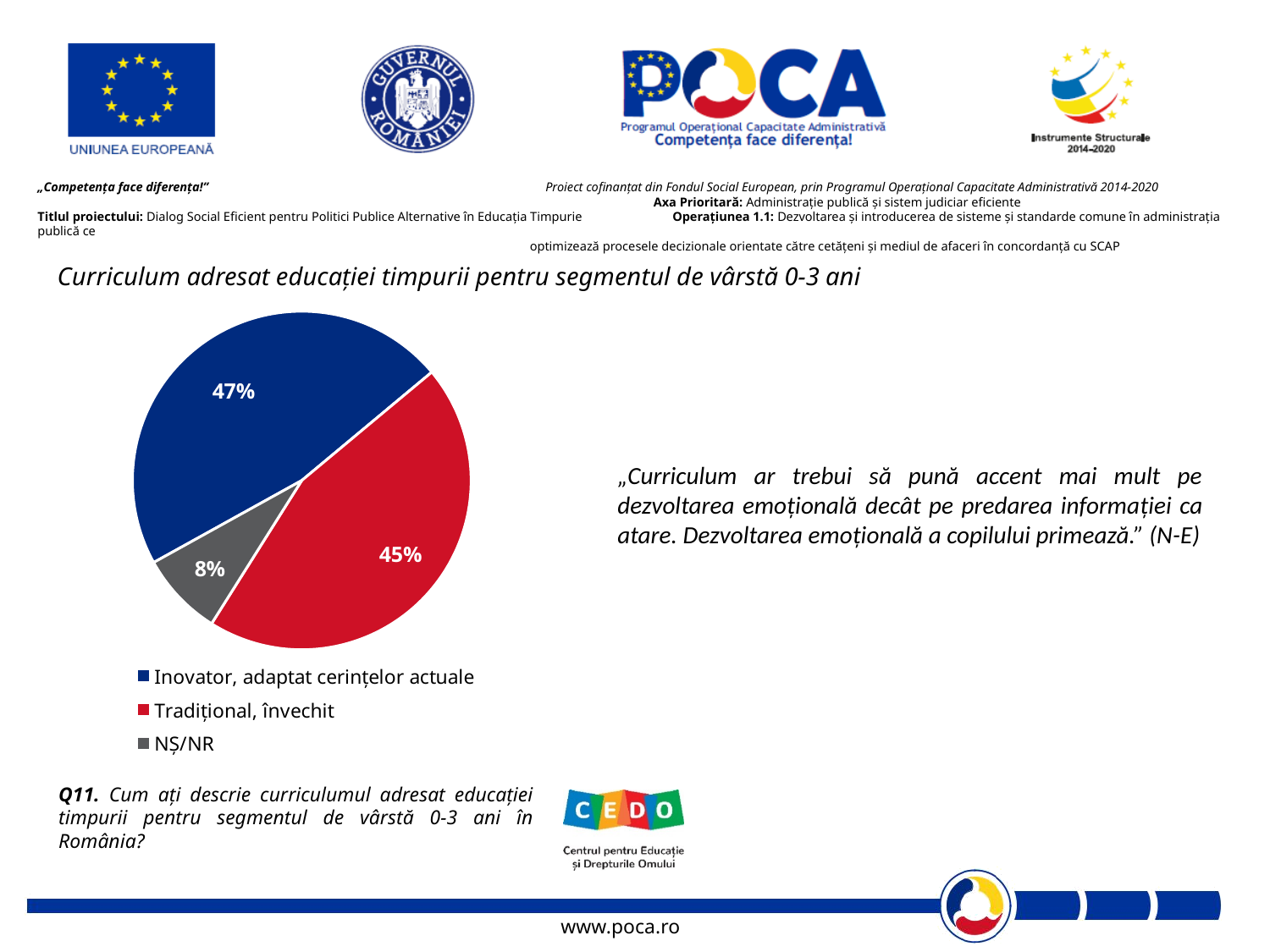
What colour is the slice for "Tradițional, învechit"? red What is the difference in percentage points between "Tradițional, învechit" and "NȘ/NR"? 37 percentage points What share of the pie is labelled "Tradițional, învechit"? 45% What share of the pie is labelled "NȘ/NR"? 8% What is the difference in percentage points between "Inovator, adaptat cerințelor actuale" and "Tradițional, învechit"? 2 percentage points Which category has the largest slice of the pie? Inovator, adaptat cerințelor actuale How many categories does the pie chart have? 3 What kind of chart is shown on the slide? pie chart What share of the pie is labelled "Inovator, adaptat cerințelor actuale"? 47% Which category has the smallest slice of the pie? NȘ/NR What is the title of the chart? Curriculum adresat educației timpurii pentru segmentul de vârstă 0-3 ani Which is larger: the share for "Tradițional, învechit" or the share for "NȘ/NR"? Tradițional, învechit